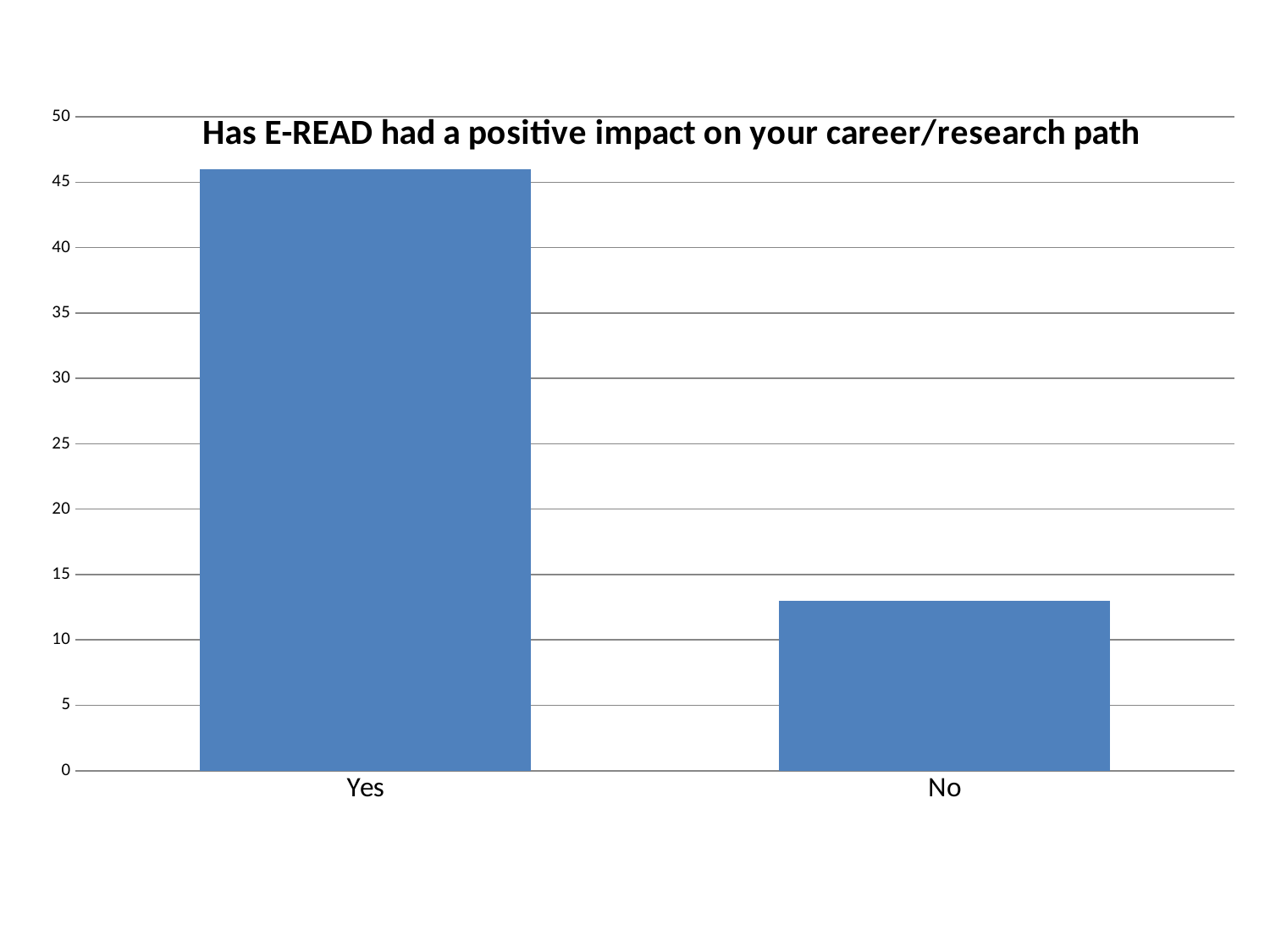
Is the value for No greater or less than 10? greater Which is larger, the value for Yes or the value for No? Yes Is the value for Yes greater or less than 50? less What is the title of the chart? Has E-READ had a positive impact on your career/research path Which category has the lowest value? No Which category has the highest value? Yes What is the maximum value shown on the vertical axis? 50 What kind of chart is shown on the slide? bar chart Is the value for Yes greater or less than 40? greater How many categories are shown on the x axis of the chart? 2